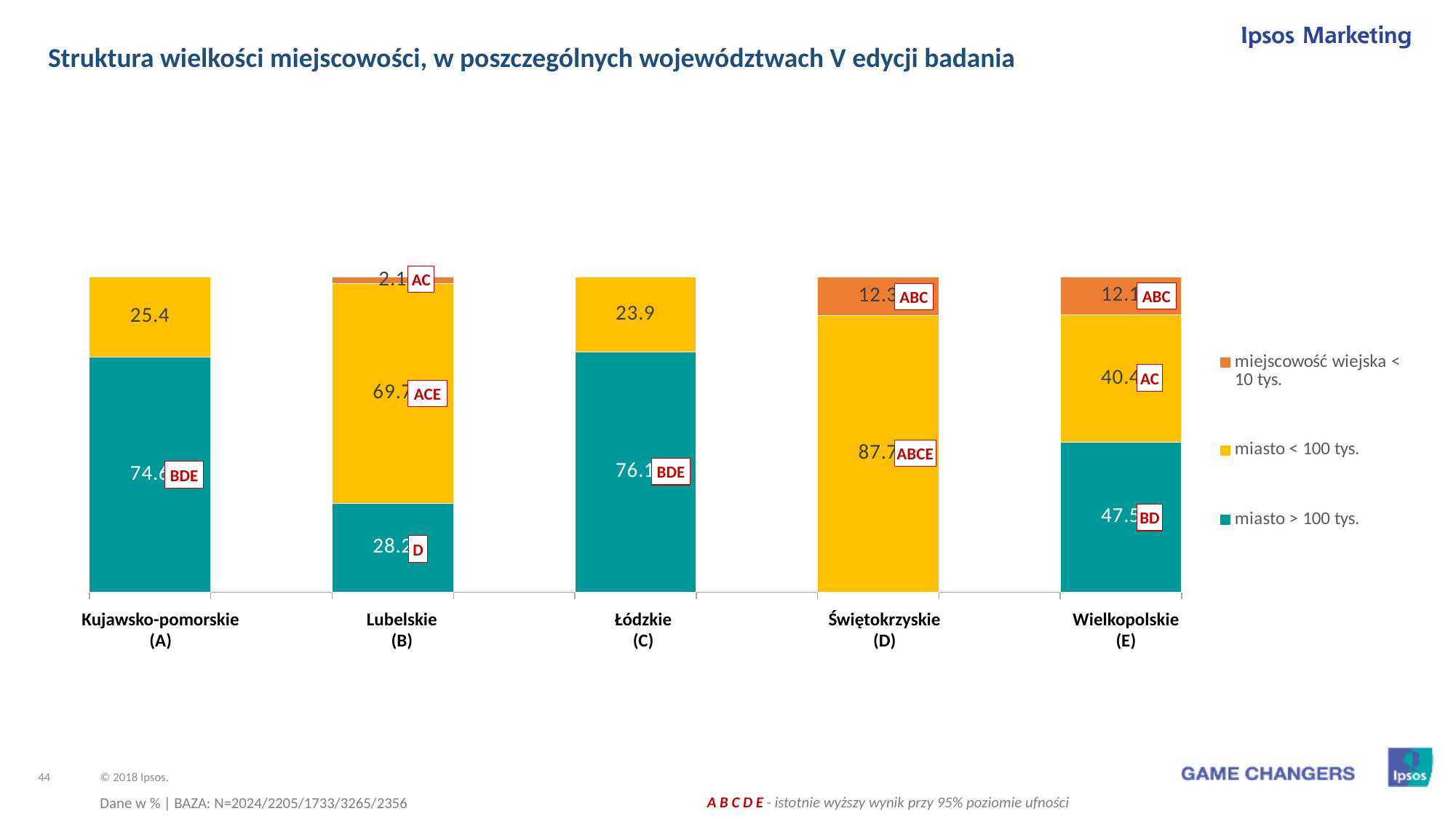
Which voivodeship has the highest value for 'miasto > 100 tys.'? Łódzkie (C) What kind of chart is shown on the slide? stacked bar chart Which series is shown in teal (the bottom segment of the bars)? miasto > 100 tys. What is the value for 'miejscowość wiejska < 10 tys.' in Lubelskie (B)? 2.1 Which voivodeship has the lowest value for 'miasto < 100 tys.'? Łódzkie (C) What is the difference between the 'miasto < 100 tys.' values for Lubelskie (B) and Wielkopolskie (E)? 29.3 How many voivodeships (categories) are shown on the x axis? 5 What is the value for 'miasto > 100 tys.' in Wielkopolskie (E)? 47.5 How many series does the legend list? 3 Which is larger: the 'miejscowość wiejska < 10 tys.' value for Świętokrzyskie (D) or for Wielkopolskie (E)? Świętokrzyskie (D) What is the value for 'miasto > 100 tys.' in Kujawsko-pomorskie (A)? 74.6 What is the value for 'miasto < 100 tys.' in Świętokrzyskie (D)? 87.7